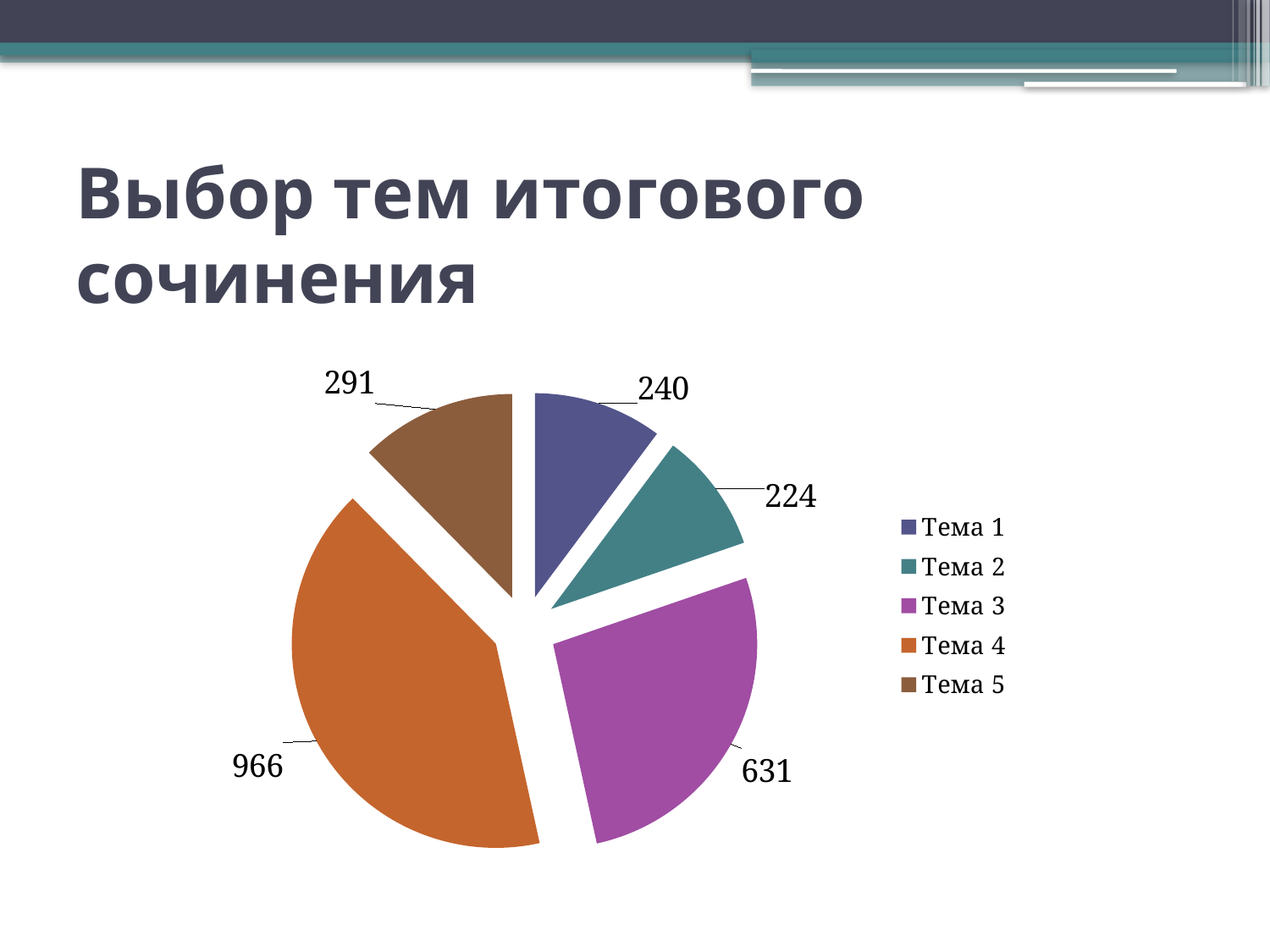
What is the value for Тема 4 in the pie chart? 966 What is the difference between the values for Тема 5 and Тема 1? 51 What is the value for Тема 2 in the pie chart? 224 Which category has the smallest slice in the pie chart? Тема 2 What type of chart is shown on the slide? Pie chart What is the difference between the values for Тема 4 and Тема 3? 335 What is the title of the slide containing the chart? Выбор тем итогового сочинения What is the value for Тема 5 in the pie chart? 291 How many categories does the pie chart show? 5 Which is larger, the value for Тема 3 or the value for Тема 5? Тема 3 Which category has the largest slice in the pie chart? Тема 4 What is the total of all the values shown in the pie chart? 2352